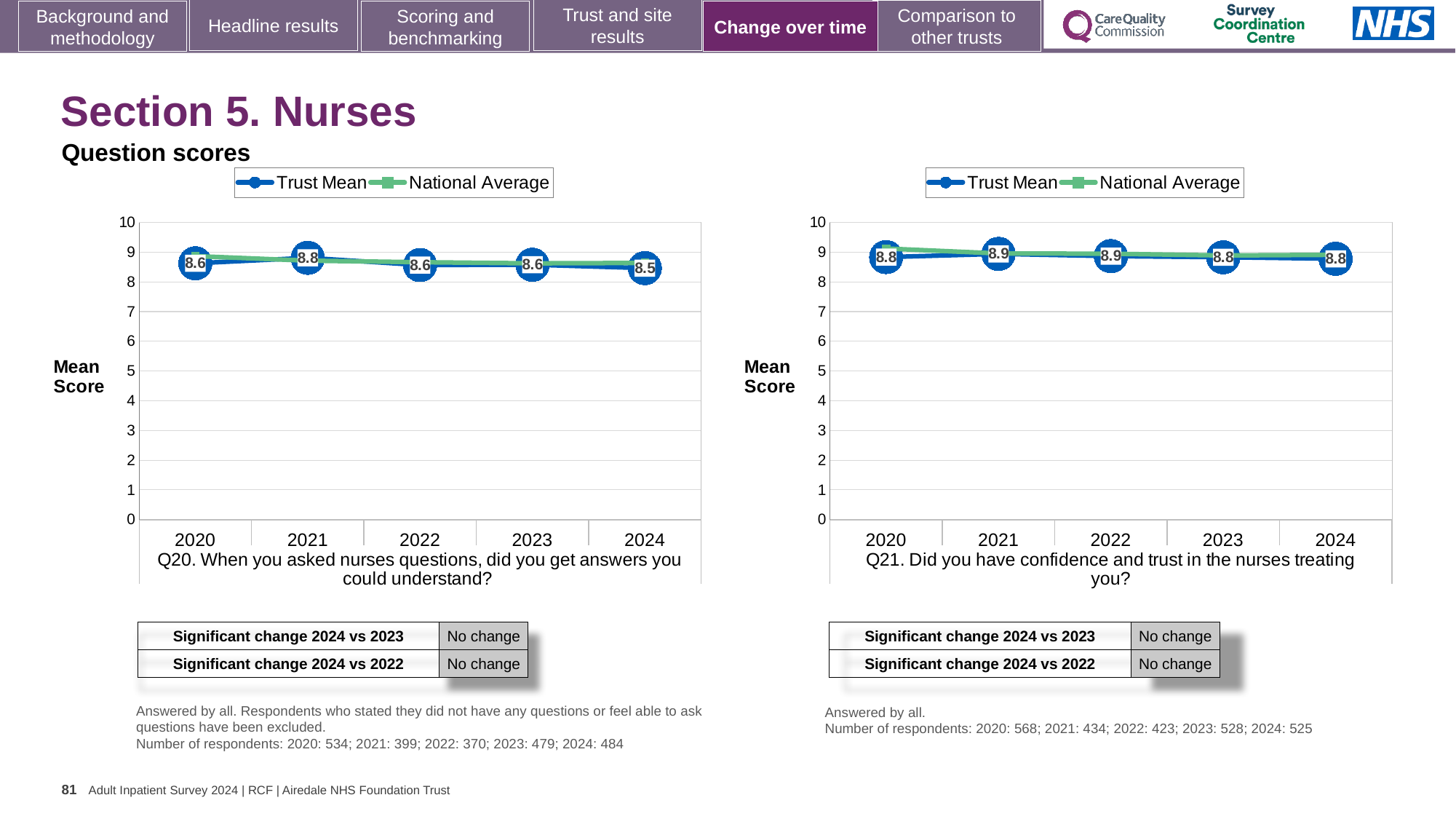
On the Q20 chart, what is the difference between the Trust Mean scores for 2021 and 2024? 0.3 On the Q20 chart, what is the Trust Mean score for 2024? 8.5 On the Q21 chart, what is the Trust Mean score for 2020? 8.8 On the Q21 chart, is the Trust Mean score for 2021 larger or smaller than the score for 2024? larger On the Q21 chart, what is the Trust Mean score for 2022? 8.9 How many years are plotted on the Q20 chart? 5 What type of chart is used for Q20? Line chart On the Q20 chart, which year has the highest Trust Mean score? 2021 How many series does the legend of the Q21 chart list? 2 On the Q20 chart, what is the Trust Mean score for 2021? 8.8 On the Q21 chart, is the Trust Mean value for 2023 greater or less than 8? greater On the Q20 chart, which year has the lowest Trust Mean score? 2024